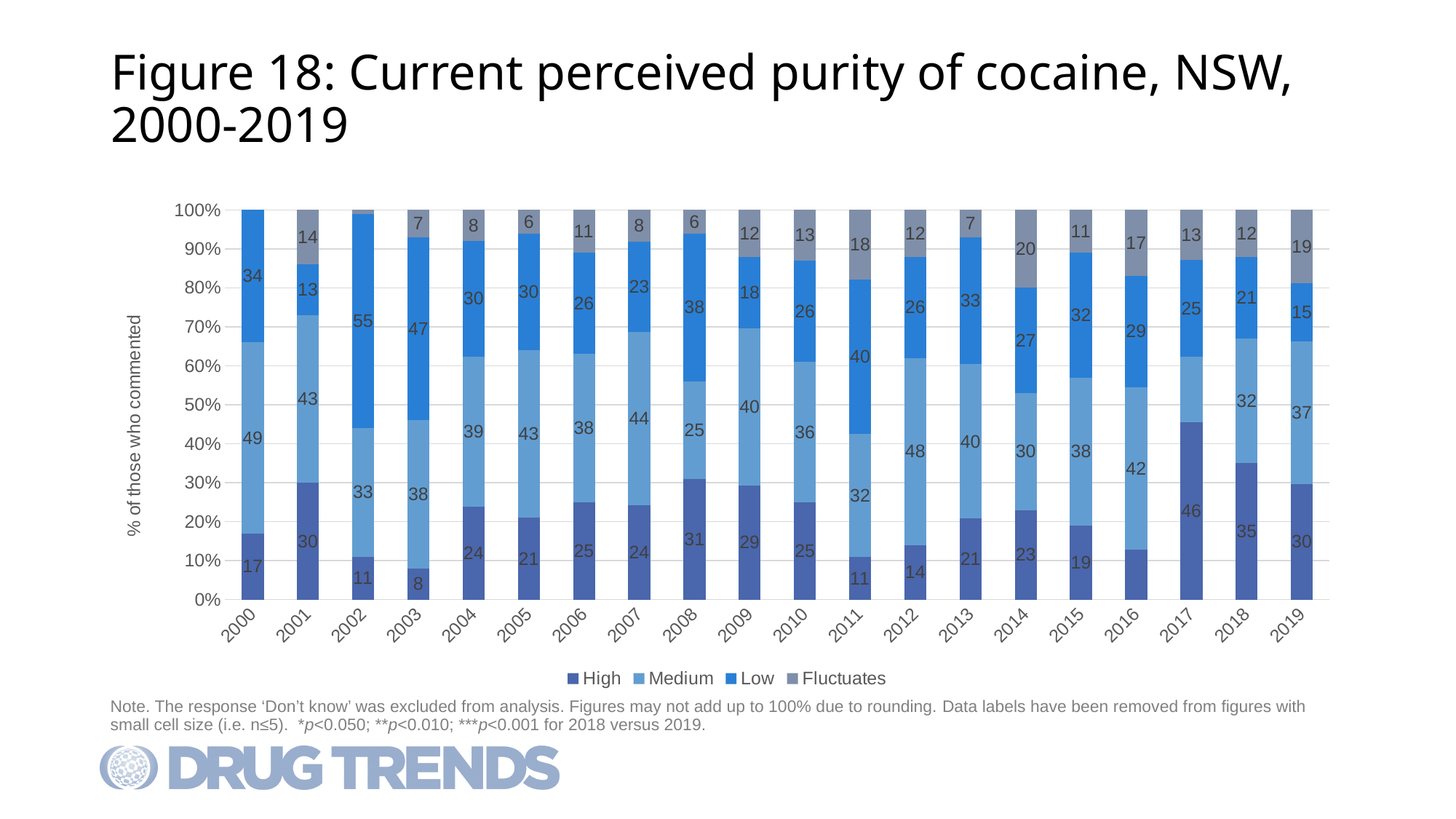
What kind of chart is shown on the slide? Stacked bar chart What is the value for Fluctuates in 2014? 20 Which is larger in 2011: the Low segment or the Medium segment? Low What is the value for Medium in 2012? 48 What is the label on the vertical axis? % of those who commented In which year is the High segment largest? 2017 What is the difference between the High values for 2018 and 2019? 5 How many years are shown on the x axis? 20 In which year is the High segment smallest? 2003 How many series does the legend list? 4 What percentage of those who commented rated cocaine purity as High in 2017? 46 What is the value for Low in 2002? 55